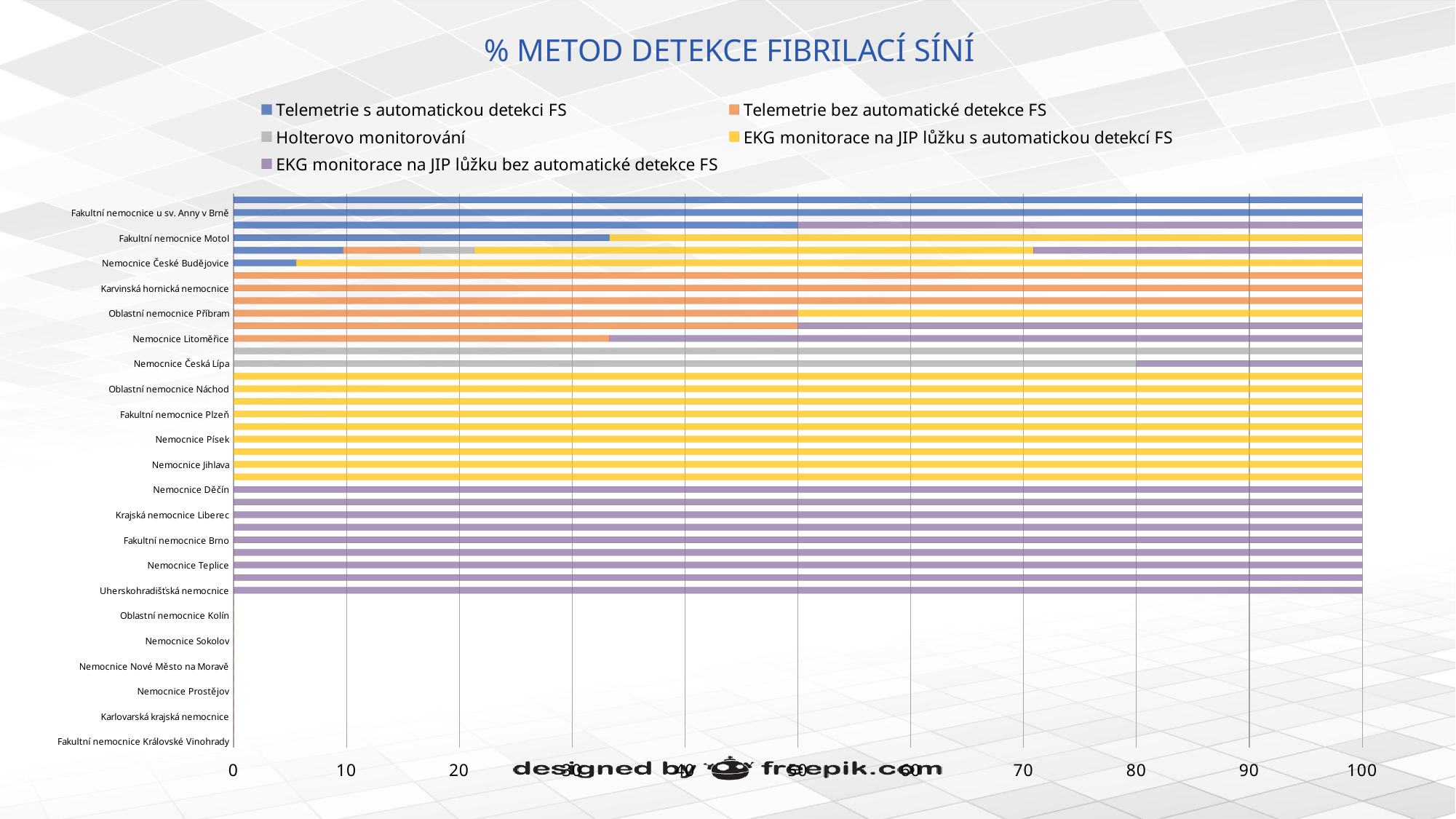
How many series does the legend list? 5 Is the Telemetrie s automatickou detekci FS value for Fakultní nemocnice Motol greater or less than 30? greater Which series makes up the entire bar for Nemocnice Jihlava? EKG monitorace na JIP lůžku s automatickou detekcí FS Is the Telemetrie bez automatické detekce FS value for Nemocnice Litoměřice greater or less than 40? less What kind of chart is shown on the slide? bar chart Which series makes up the entire bar for Nemocnice Děčín? EKG monitorace na JIP lůžku bez automatické detekce FS Is the Telemetrie s automatickou detekci FS value for Fakultní nemocnice Motol greater or less than 40? less What is the title of the chart? % METOD DETEKCE FIBRILACÍ SÍNÍ Which colour represents Holterovo monitorování in the legend? grey Which series makes up the entire bar for Karvinská hornická nemocnice? Telemetrie bez automatické detekce FS